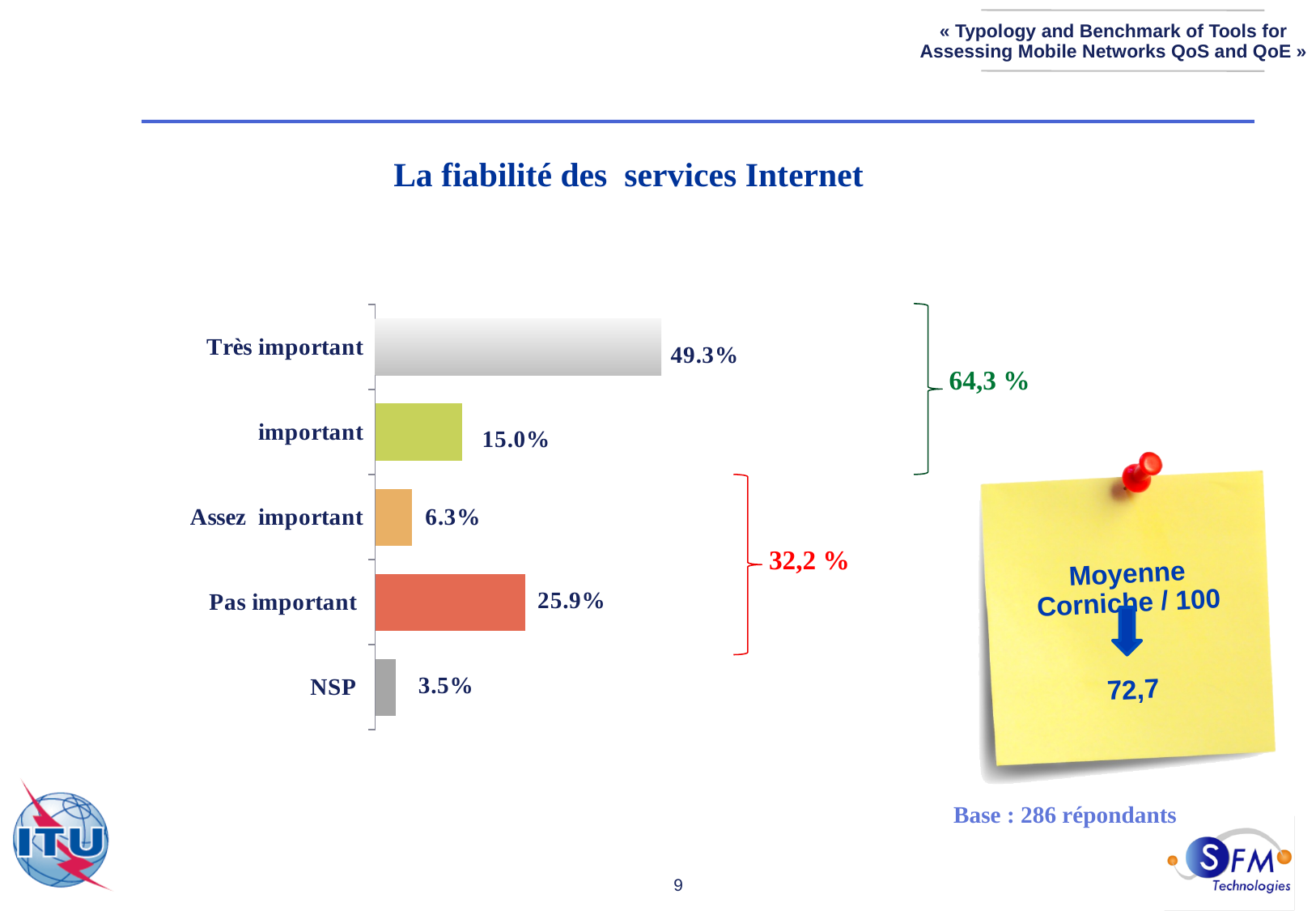
Which is larger, the value for important or the value for Pas important? Pas important What is the title of the chart? La fiabilité des services Internet What kind of chart is shown on the slide? Bar chart Which category has the lowest value? NSP What is the difference between the values for Pas important and Assez important? 19.6% Which category has the highest value? Très important What is the value for NSP? 3.5% What is the difference between the values for Très important and important? 34.3% What is the value for Assez important? 6.3% What is the value for Très important? 49.3% How many categories are shown in the chart? 5 What is the value for Pas important? 25.9%